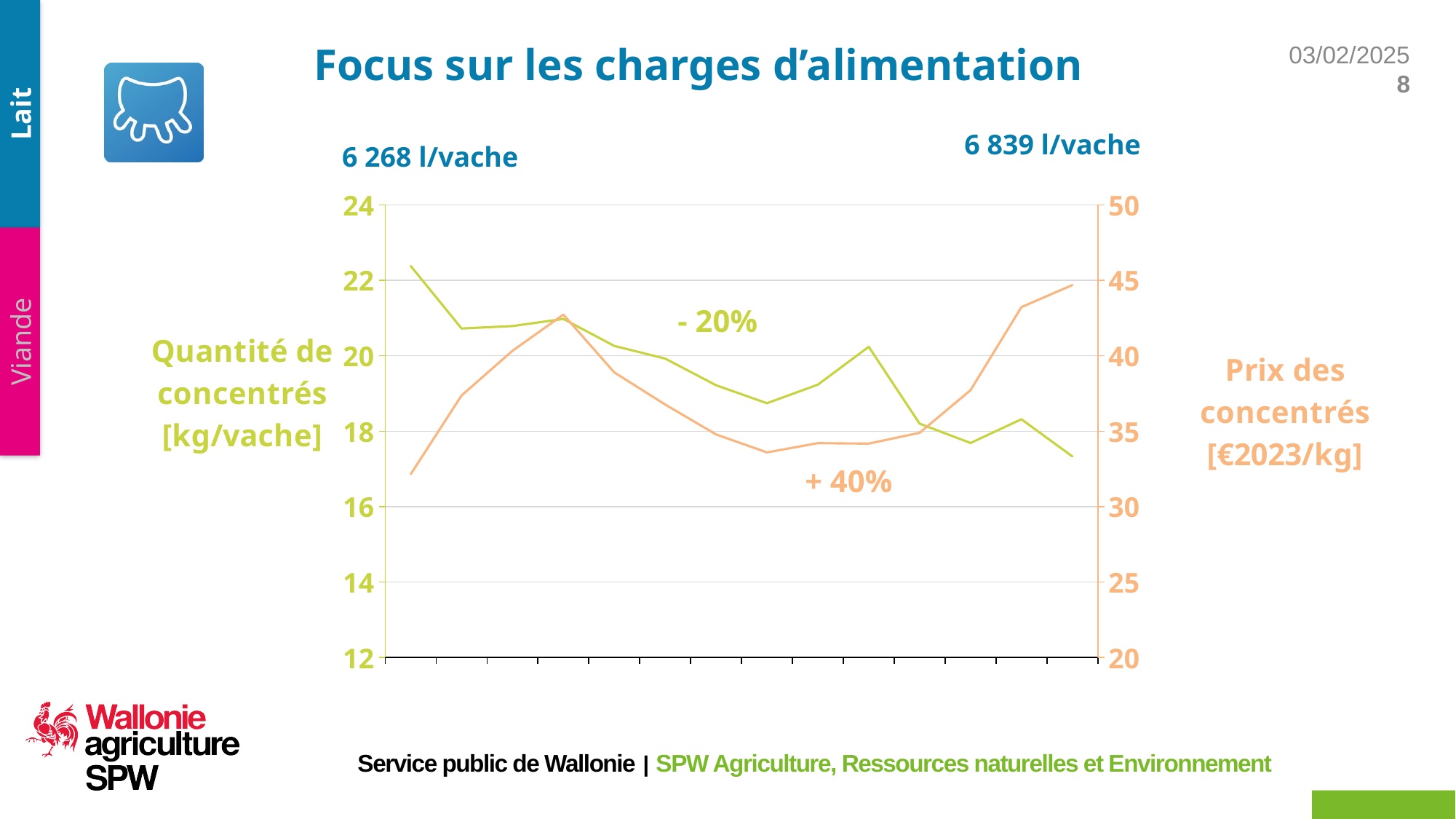
Is the last value of the orange line (Prix des concentrés) greater or less than 40? greater How many series are plotted on the chart? 2 Is the last value of the green line (Quantité de concentrés) greater or less than 18? less Overall, does the green line (Quantité de concentrés) rise or fall from left to right? fall What does the left (green) axis of the chart represent? Quantité de concentrés [kg/vache] Overall, does the orange line (Prix des concentrés) rise or fall from left to right? rise What is the title of the slide containing the chart? Focus sur les charges d’alimentation What percentage change is annotated next to the orange line (Prix des concentrés)? + 40% What percentage change is annotated next to the green line (Quantité de concentrés)? - 20% What kind of chart is shown on the slide? line chart Is the first value of the orange line (Prix des concentrés) greater or less than 35? less